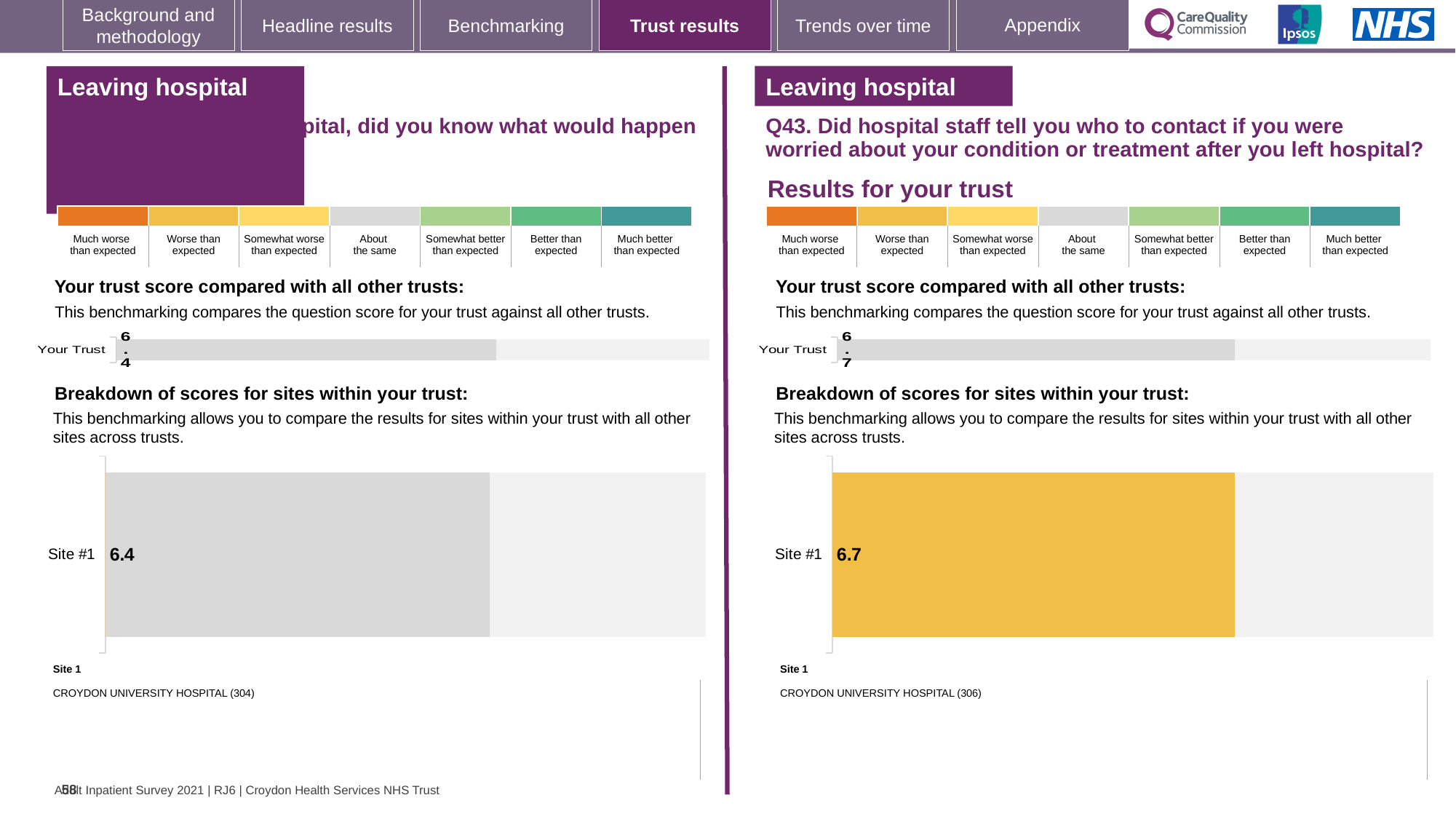
How many sites are plotted in the 'Breakdown of scores for sites within your trust' chart on the right half of the slide (Q43)? 1 Which site name is listed under 'Site 1' for the Q43 breakdown chart on the right half of the slide? CROYDON UNIVERSITY HOSPITAL (306) On the right half of the slide (Q43), in the 'Breakdown of scores for sites within your trust' chart, what is the score for Site #1? 6.7 Which is larger: the Site #1 score in the left-hand breakdown chart or the Site #1 score in the right-hand (Q43) breakdown chart? Right-hand (Q43) chart What kind of chart is used for the 'Breakdown of scores for sites within your trust' on the right half of the slide (Q43)? Bar chart On the right half of the slide (Q43), in the 'Your trust score compared with all other trusts' chart, what is the score for Your Trust? 6.7 What colour is the Site #1 bar in the breakdown chart on the right half of the slide (Q43)? Yellow On the left half of the slide, in the 'Breakdown of scores for sites within your trust' chart, what is the score for Site #1? 6.4 Is the Site #1 score in the left-hand breakdown chart greater or less than 6.5? less On the left half of the slide, in the 'Your trust score compared with all other trusts' chart, what is the score for Your Trust? 6.4 How many sites are plotted in the 'Breakdown of scores for sites within your trust' chart on the left half of the slide? 1 What is the difference between the Your Trust score on the right half (Q43) and the Your Trust score on the left half of the slide? 0.3